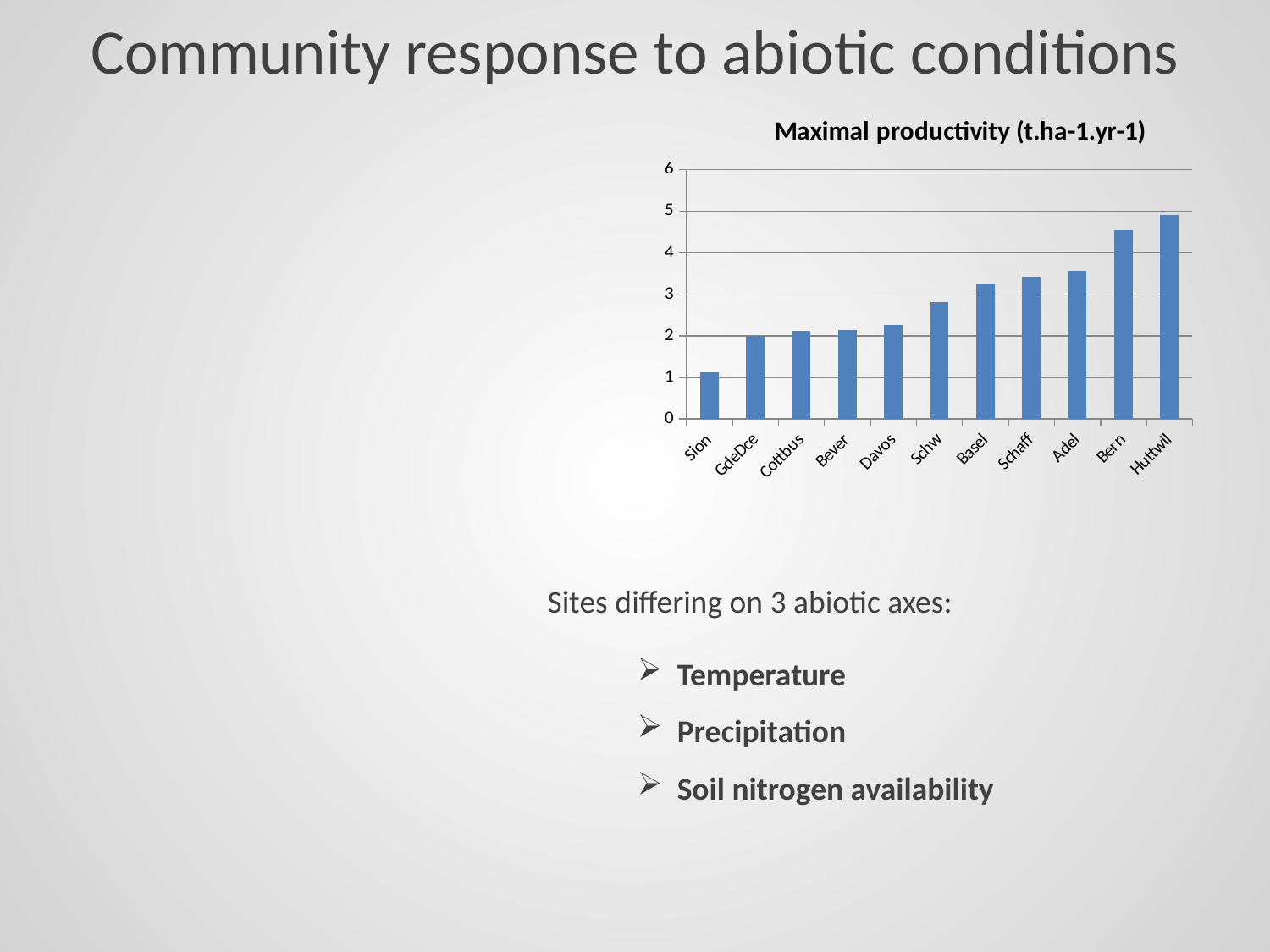
Which site has the highest maximal productivity? Huttwil Is the value for Sion greater or less than 2? less What kind of chart is shown on the slide? bar chart Which has the larger maximal productivity, Bern or Basel? Bern Do the values rise or fall from left to right along the x axis? rise What is the title of the chart? Maximal productivity (t.ha-1.yr-1) Is the value for Adel greater or less than 3? greater Is the value for Huttwil greater or less than 4? greater How many sites are shown on the x axis of the chart? 11 Which site has the lowest maximal productivity? Sion